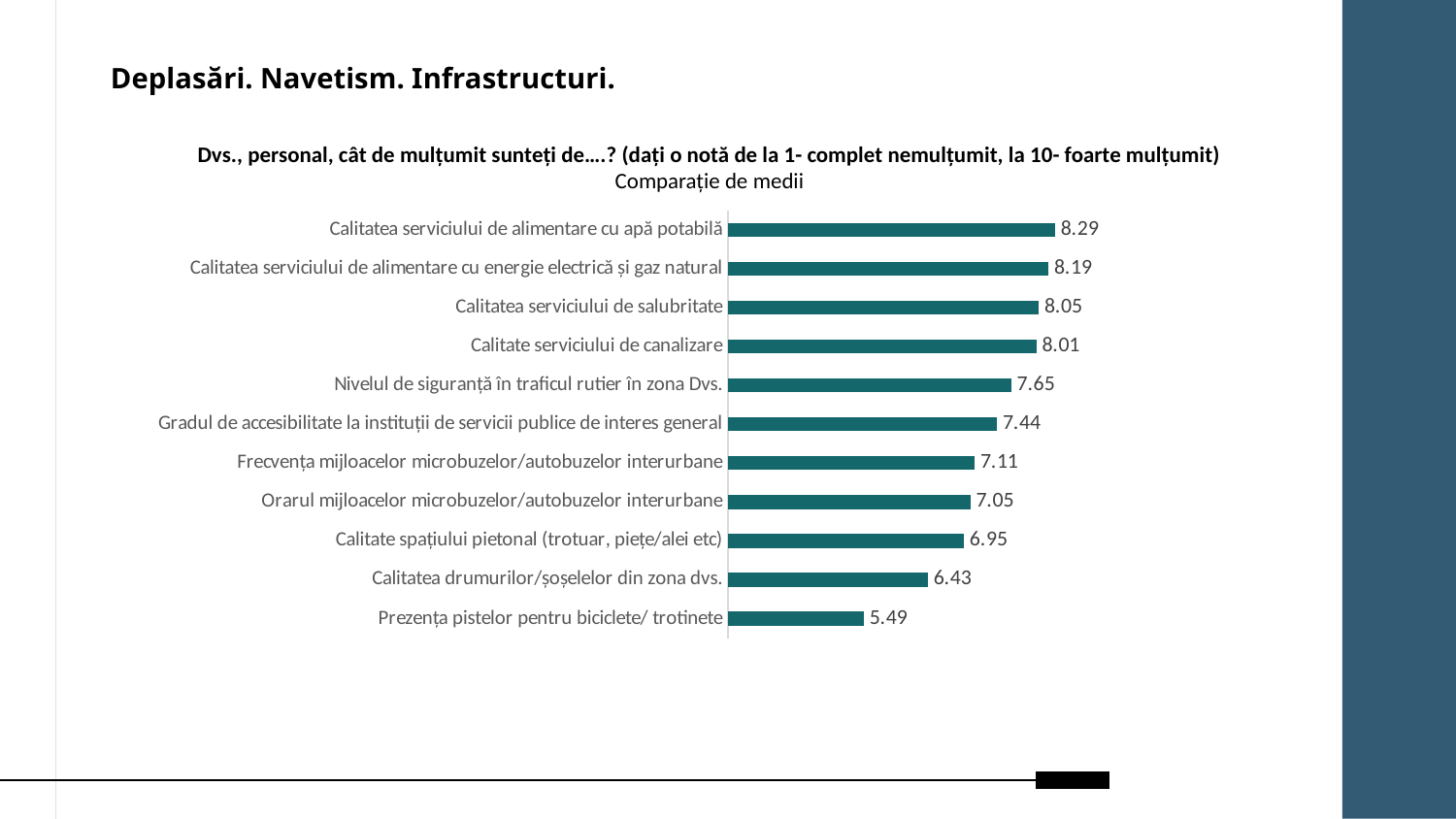
What is the value for "Calitatea serviciului de alimentare cu apă potabilă"? 8.29 What is the value for "Nivelul de siguranță în traficul rutier în zona Dvs."? 7.65 What is the value for "Prezența pistelor pentru biciclete/ trotinete"? 5.49 Which category has the lowest value? Prezența pistelor pentru biciclete/ trotinete Which is larger: the value for "Calitatea serviciului de salubritate" or the value for "Calitate spațiului pietonal (trotuar, piețe/alei etc)"? Calitatea serviciului de salubritate What is the subtitle shown below the chart's question title? Comparație de medii What is the value for "Calitatea drumurilor/șoselelor din zona dvs."? 6.43 What kind of chart is shown on the slide? Bar chart Which category has the highest value? Calitatea serviciului de alimentare cu apă potabilă What is the difference between the values for "Calitatea serviciului de alimentare cu apă potabilă" and "Prezența pistelor pentru biciclete/ trotinete"? 2.80 What is the difference between the values for "Frecvența mijloacelor microbuzelor/autobuzelor interurbane" and "Orarul mijloacelor microbuzelor/autobuzelor interurbane"? 0.06 How many categories are shown in the chart? 11